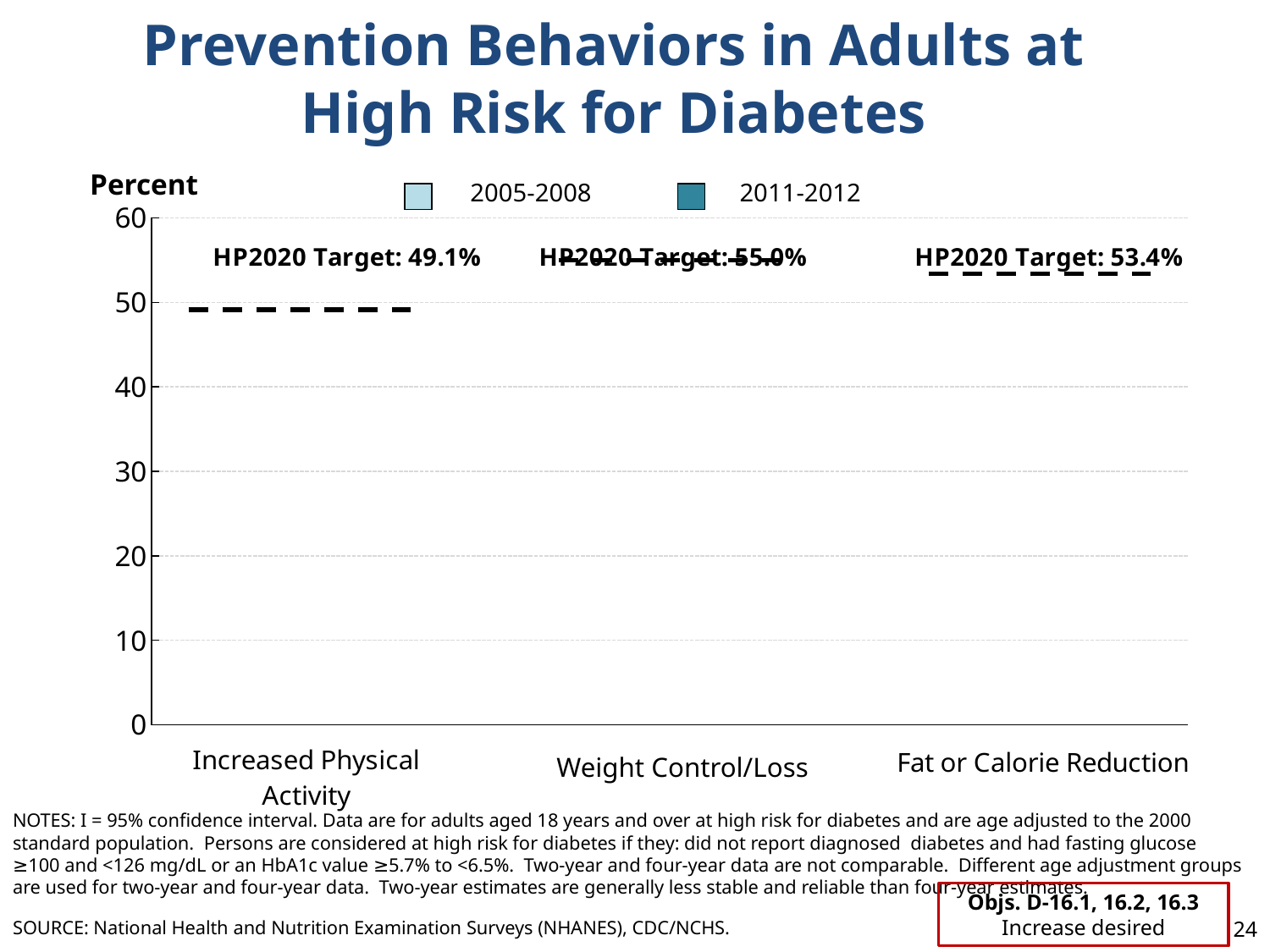
What is the maximum value shown on the vertical axis? 60 How many categories are shown on the x axis? 3 Is the HP2020 Target for Fat or Calorie Reduction higher or lower than the target for Weight Control/Loss? lower What are the two series named in the legend? 2005-2008 and 2011-2012 What is the difference between the HP2020 Targets for Weight Control/Loss and Increased Physical Activity? 5.9% What is the HP2020 Target shown for Fat or Calorie Reduction? 53.4% What is the label on the vertical axis? Percent What is the HP2020 Target shown for Increased Physical Activity? 49.1% Which category has the lowest HP2020 Target? Increased Physical Activity How many series does the legend list? 2 Which category has the highest HP2020 Target? Weight Control/Loss What is the HP2020 Target shown for Weight Control/Loss? 55.0%